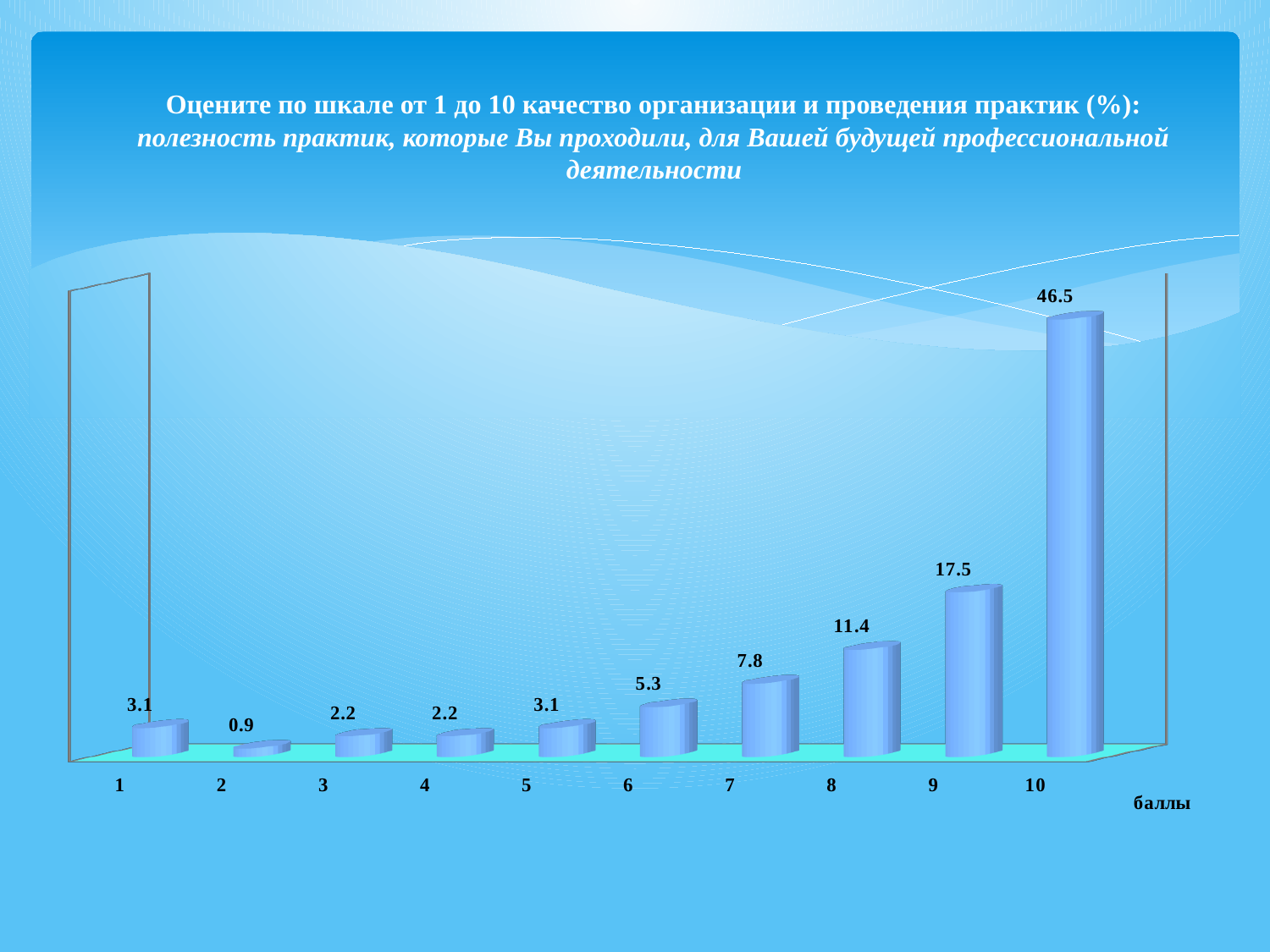
What is the value for score 6? 5.3 How many scores (categories) are shown on the x axis? 10 What is the value for score 10? 46.5 What is the difference between the values for score 8 and score 7? 3.6 Which score has the lowest value? 2 Do the values generally rise or fall from score 2 to score 10? rise Which score has the highest value? 10 What is the difference between the values for score 10 and score 9? 29 What kind of chart is shown on the slide? bar chart What is the value for score 2? 0.9 What is the label of the x axis? баллы Which is larger, the value for score 9 or the value for score 8? 9